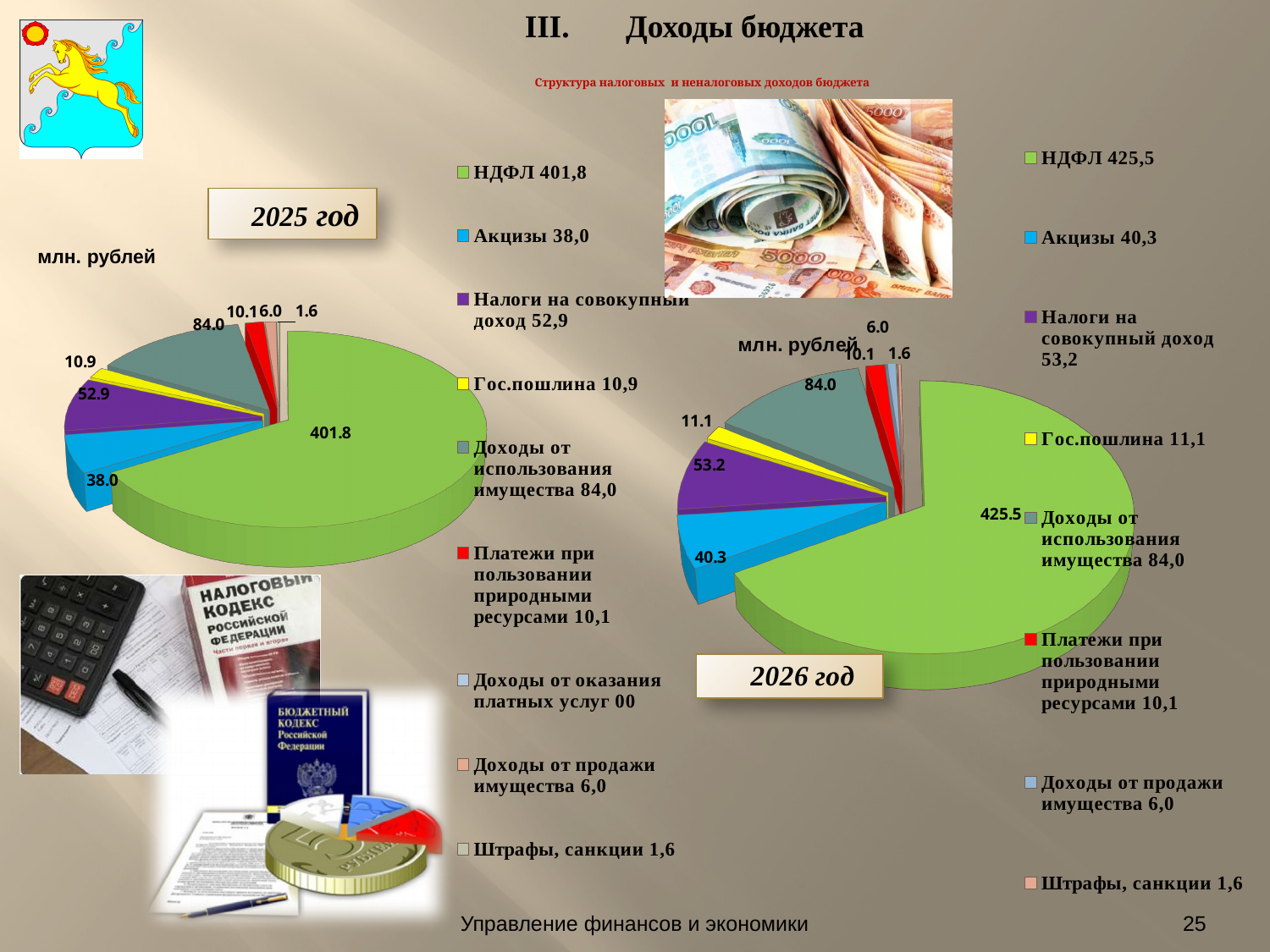
In the 2026 год chart, what is the difference between Доходы от использования имущества and Акцизы? 43,7 How many categories does the legend of the 2026 год chart list? 8 How many categories does the legend of the 2025 год chart list? 9 In the 2026 год chart, what is the value for Налоги на совокупный доход? 53,2 In the 2025 год chart, what is the value for Гос.пошлина? 10,9 In the 2025 год chart, which category has the smallest non-zero value? Штрафы, санкции In the 2026 год chart, what is the value for Акцизы? 40,3 What is the difference between НДФЛ in the 2026 год chart and НДФЛ in the 2025 год chart? 23,7 What type of chart is used for the 2025 год data? pie chart In the 2025 год chart, what is the value for НДФЛ? 401,8 In the 2026 год chart, which category has the largest value? НДФЛ In the 2025 год chart, which is larger: Акцизы or Налоги на совокупный доход? Налоги на совокупный доход